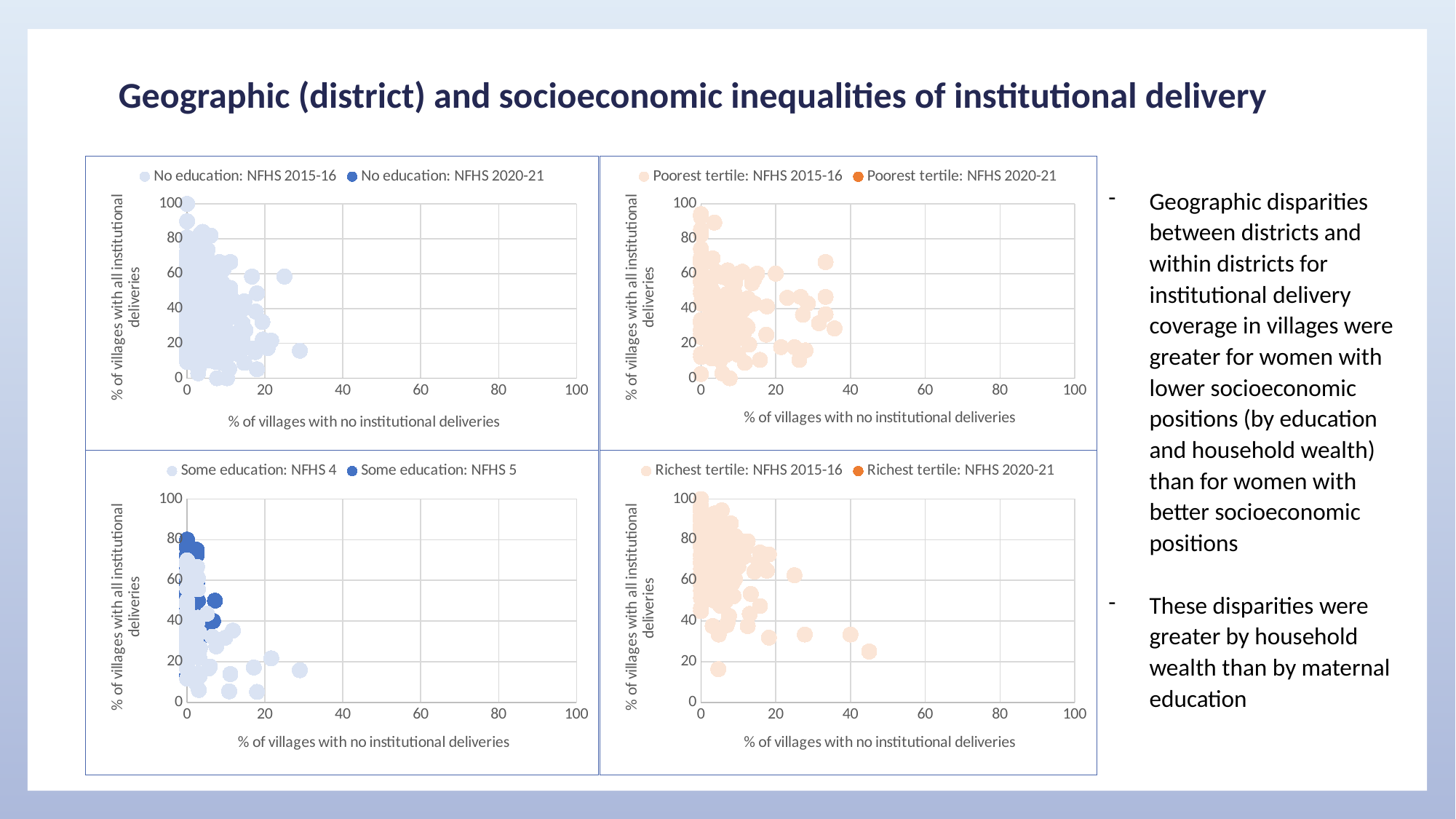
How many charts are shown on the slide? 4 In the top-right chart, is the rightmost point's x value greater or less than 60? less In the top-left chart, do any points have an x value greater than 40? No In the bottom-right chart, is the rightmost point's x value greater or less than 40? greater How many series does the legend of the bottom-right chart list? 2 How many series does the legend of the top-right chart list? 2 What is the x-axis title of the bottom-right chart? % of villages with no institutional deliveries What are the two series named in the legend of the bottom-left chart? Some education: NFHS 4 and Some education: NFHS 5 What is the maximum value shown on the y axis of the top-left chart? 100 What kind of chart is the top-left chart on the slide? Scatter chart What is the x-axis tick interval shown on the top-right chart? 20